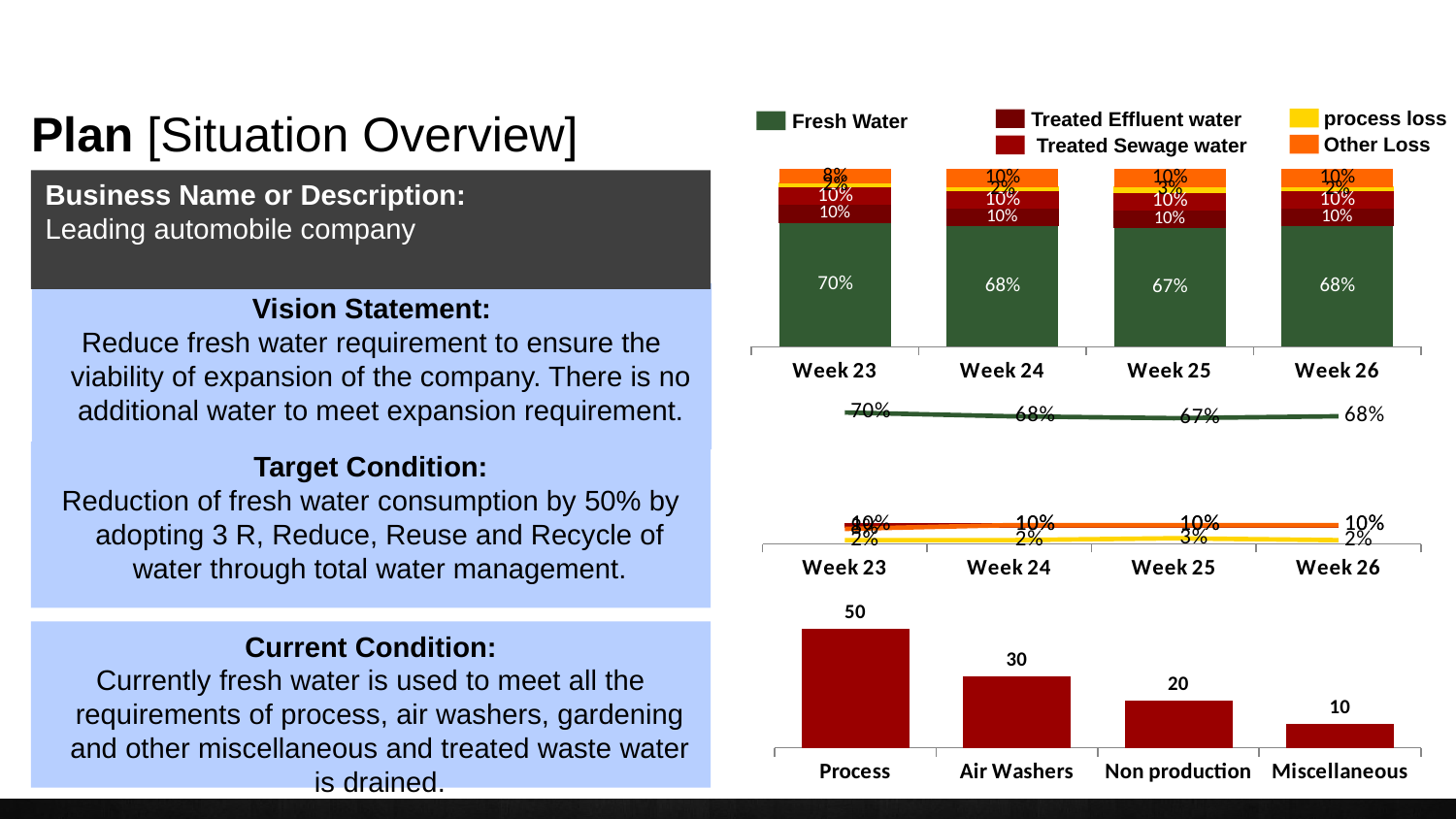
What kind of chart is the bottom chart on the slide? bar chart In the bottom bar chart, what is the value for Process? 50 In the bottom bar chart, do the values rise or fall from Process to Miscellaneous? fall How many categories are shown in the bottom bar chart? 4 In the top stacked bar chart, which week has the highest Fresh Water share? Week 23 In the bottom bar chart, what is the value for Miscellaneous? 10 In the bottom bar chart, what is the difference between the values for Process and Air Washers? 20 In the bottom bar chart, which is larger, Air Washers or Non production? Air Washers In the bottom bar chart, which category has the highest value? Process In the top stacked bar chart, what is the Fresh Water value for Week 25? 67% How many series does the legend of the top stacked bar chart list? 5 In the bottom bar chart, which category has the lowest value? Miscellaneous